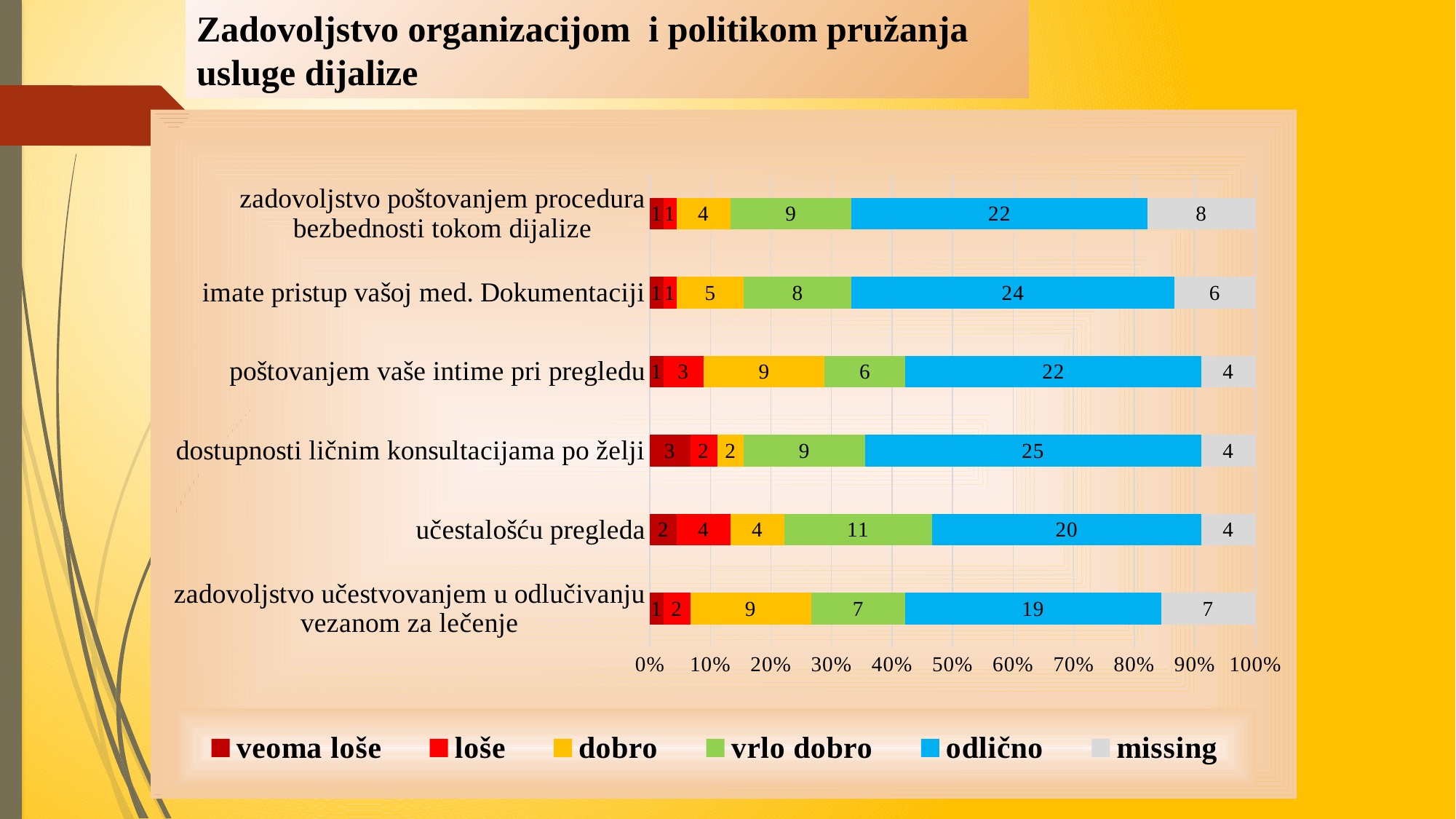
How many categories are plotted on the chart? 6 How many series does the legend list? 6 What is the 'odlično' value for 'imate pristup vašoj med. Dokumentaciji'? 24 Which category has the lowest 'odlično' value? zadovoljstvo učestvovanjem u odlučivanju vezanom za lečenje What is the 'vrlo dobro' value for 'učestalošću pregleda'? 11 What kind of chart is shown on the slide? stacked bar chart What is the difference between the 'odlično' values for 'dostupnosti ličnim konsultacijama po želji' and 'učestalošću pregleda'? 5 Which is larger: the 'loše' value for 'učestalošću pregleda' or for 'poštovanjem vaše intime pri pregledu'? učestalošću pregleda What is the 'dobro' value for 'poštovanjem vaše intime pri pregledu'? 9 Which category has the highest 'odlično' value? dostupnosti ličnim konsultacijama po želji What is the total of all segments in the bar for 'učestalošću pregleda'? 45 What is the 'missing' value for 'zadovoljstvo poštovanjem procedura bezbednosti tokom dijalize'? 8